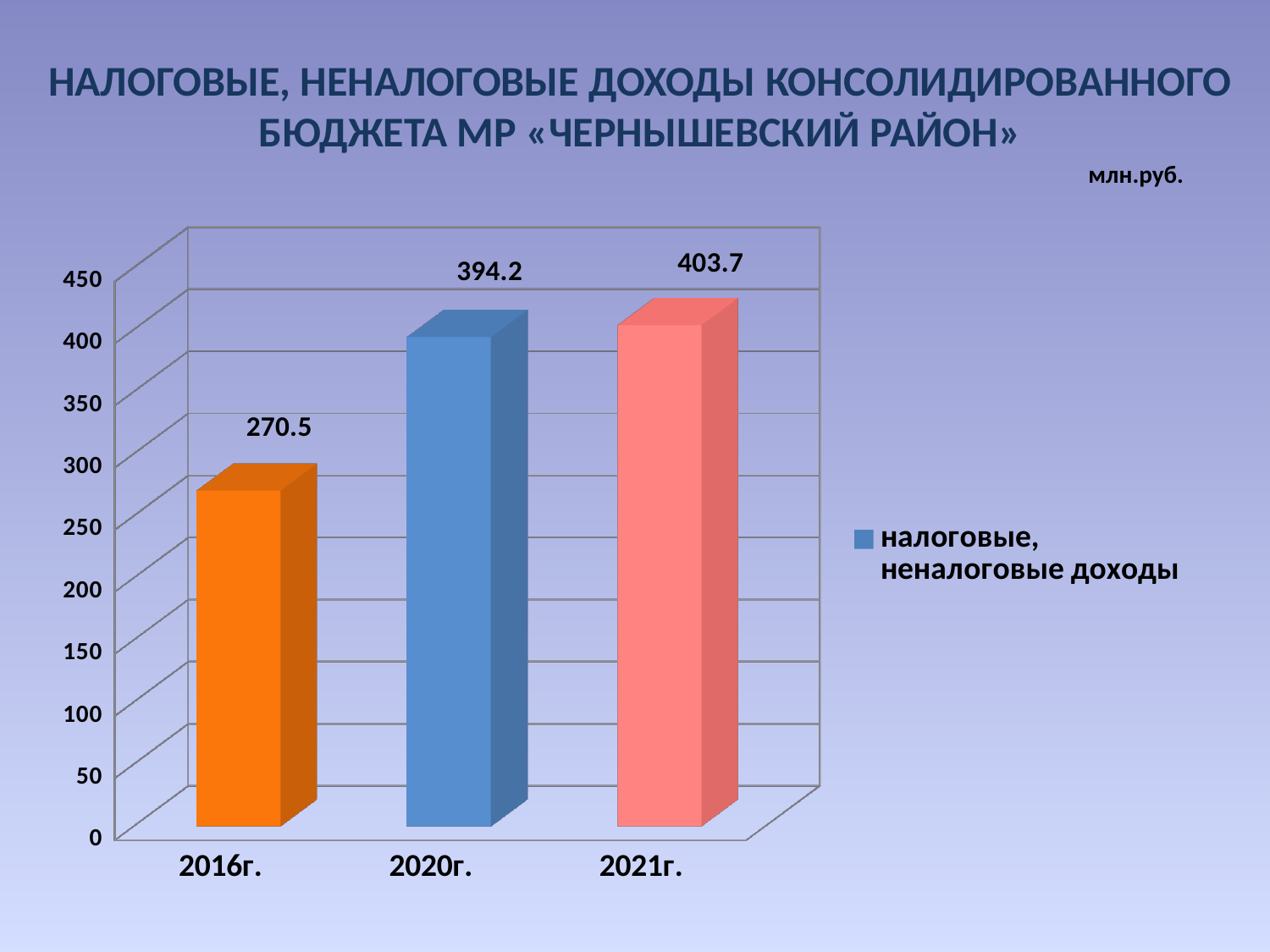
Is the value for 2016г. greater or less than 300? less Which year has the lowest value? 2016г. What is the difference between the values for 2021г. and 2016г.? 133.2 What is the value for 2020г.? 394.2 What is the difference between the values for 2020г. and 2016г.? 123.7 What unit is indicated for the values on the chart? млн.руб. How many years are shown on the chart? 3 Which is larger, the value for 2016г. or the value for 2020г.? 2020г. What is the value for 2016г.? 270.5 What is the value for 2021г.? 403.7 Which year has the highest value? 2021г. What kind of chart is shown on the slide? bar chart